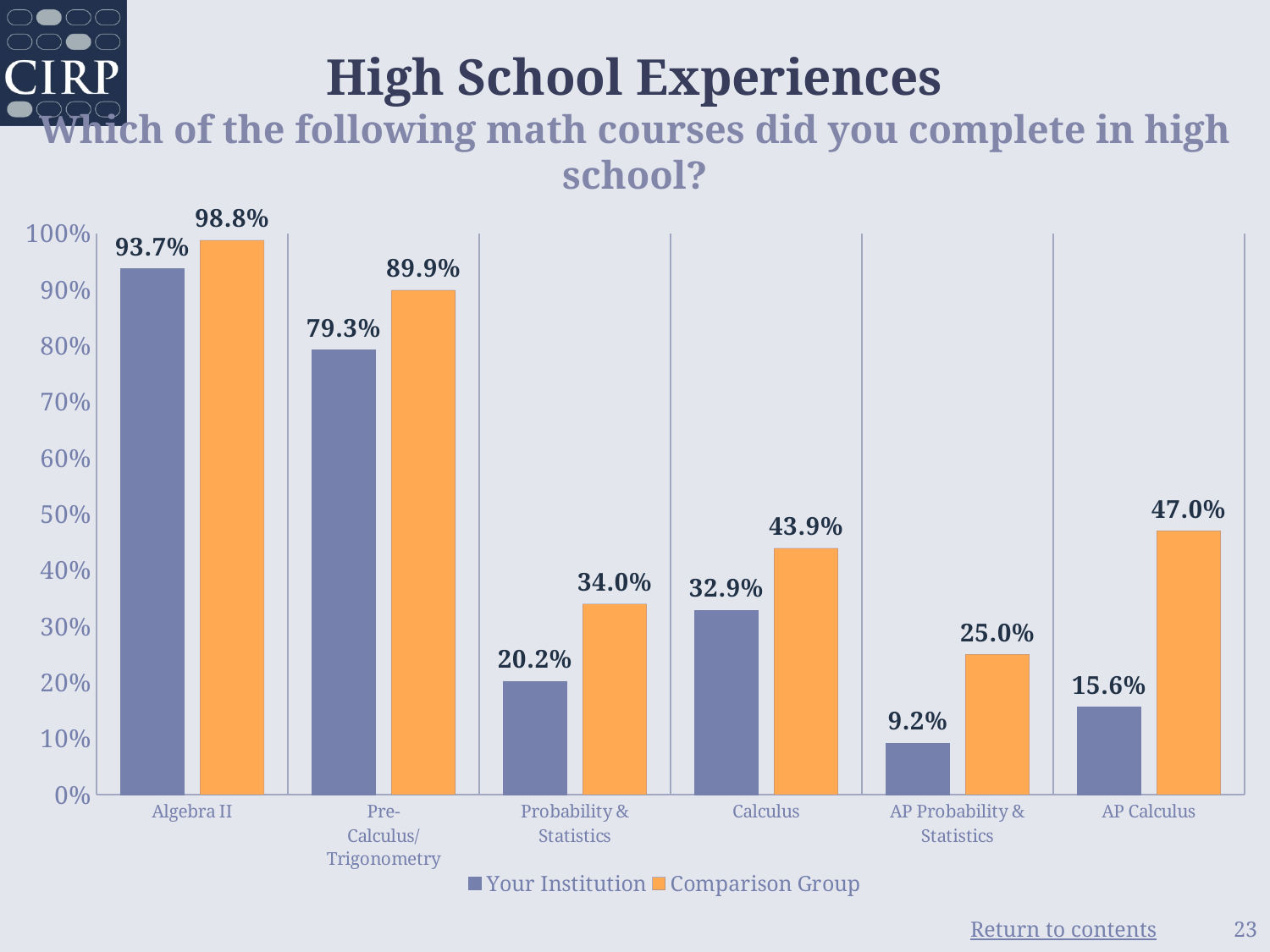
What colour are the bars for the Comparison Group? Orange What is the difference between the Comparison Group and Your Institution values for Pre-Calculus/Trigonometry? 10.6% Which course has the lowest value for Your Institution? AP Probability & Statistics Which is larger for Calculus: Your Institution or the Comparison Group? Comparison Group What is the value for Your Institution for AP Probability & Statistics? 9.2% What is the value for Your Institution for Algebra II? 93.7% What kind of chart is shown on the slide? Bar chart What is the value for the Comparison Group for AP Calculus? 47.0% Which course has the highest value for the Comparison Group? Algebra II What is the difference between the Comparison Group and Your Institution values for AP Calculus? 31.4% How many series does the legend list? 2 How many math courses are shown on the x axis? 6